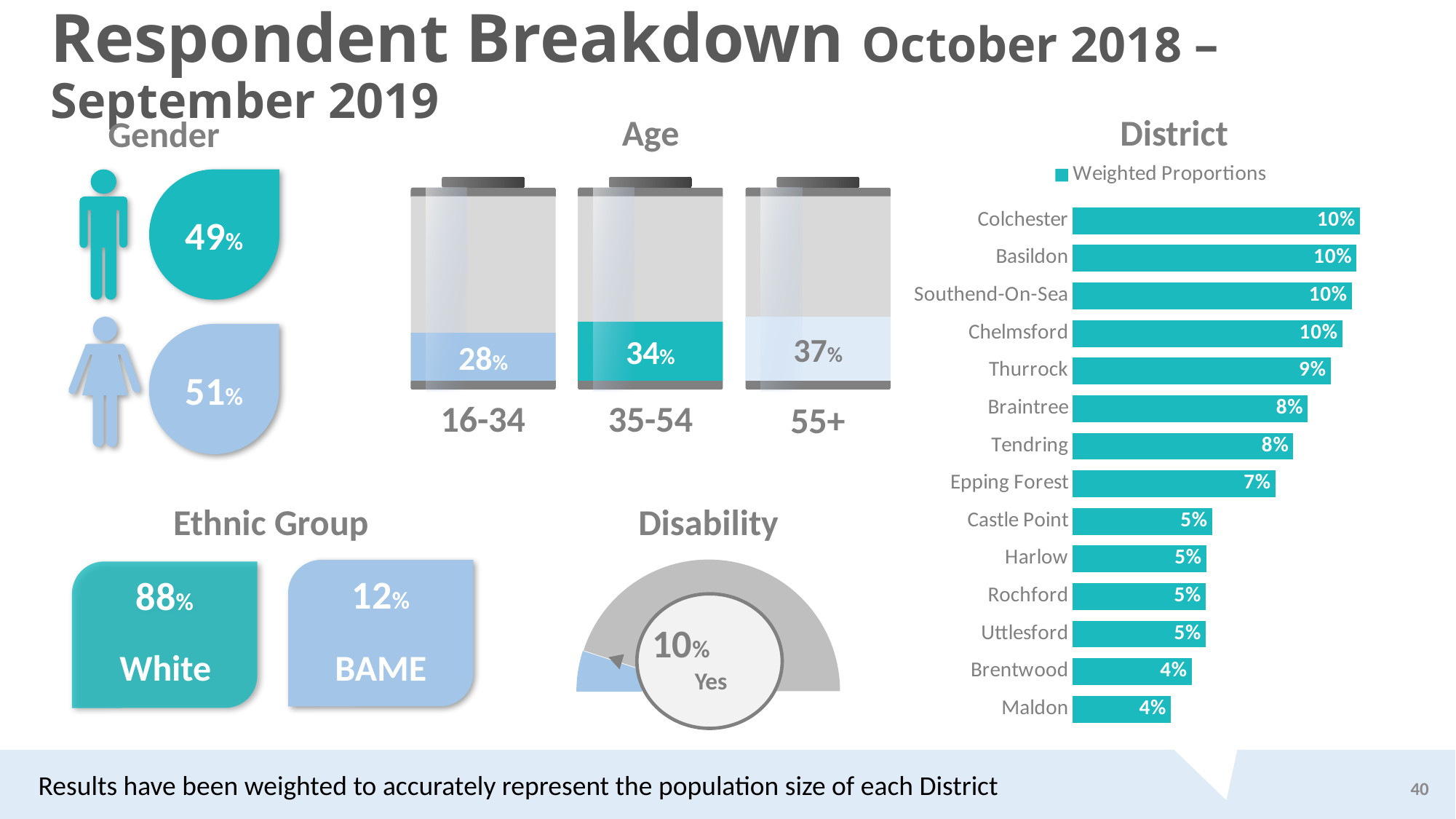
In the District chart, what is the weighted proportion for Castle Point? 5% In the District chart, how many districts are listed? 14 In the District chart, do the values rise or fall going from the top bar to the bottom bar? Fall In the District chart, what is the weighted proportion for Thurrock? 9% In the District chart, which has the larger weighted proportion, Thurrock or Harlow? Thurrock In the District chart, how many series does the legend list? 1 In the District chart, what is the weighted proportion for Brentwood? 4% What kind of chart is the District chart? Bar chart In the Age section, what percentage of respondents are aged 35-54? 34% In the District chart, what is the difference between the weighted proportions for Colchester and Maldon? 6 percentage points In the District chart, what is the weighted proportion for Epping Forest? 7% What is the name of the series shown in the District chart's legend? Weighted Proportions